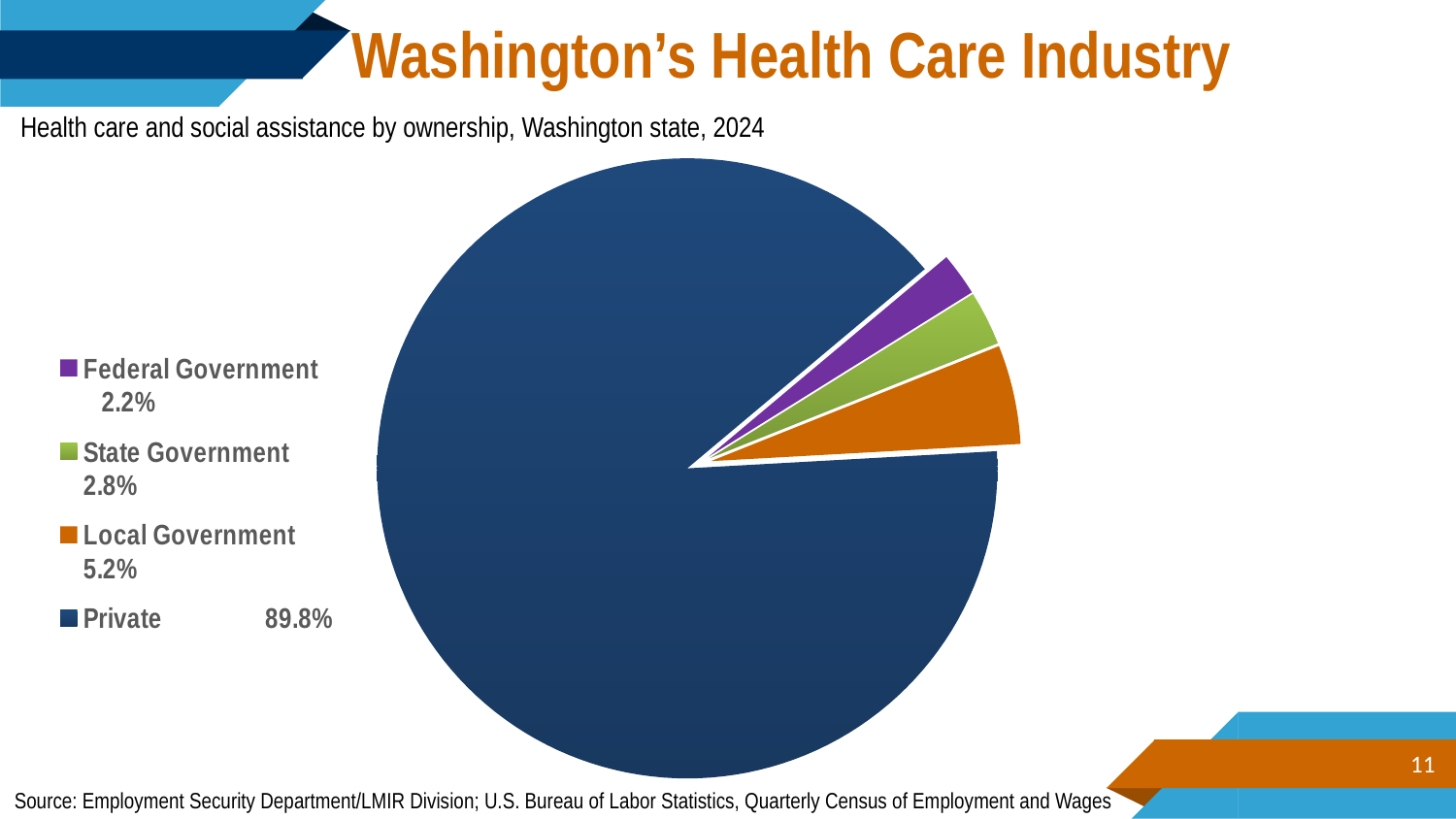
What share is State Government? 2.8% Which ownership category has the largest share? Private What share of health care and social assistance employment is Private? 89.8% Which ownership category has the smallest share? Federal Government What is the combined share of the three government categories? 10.2% What kind of chart is shown on the slide? Pie chart How many slices does the pie chart have? 4 What share is Local Government? 5.2% What is the difference in share between Local Government and State Government? 2.4% What colour is the Local Government slice? Orange Which is larger, the State Government share or the Federal Government share? State Government What share is Federal Government? 2.2%